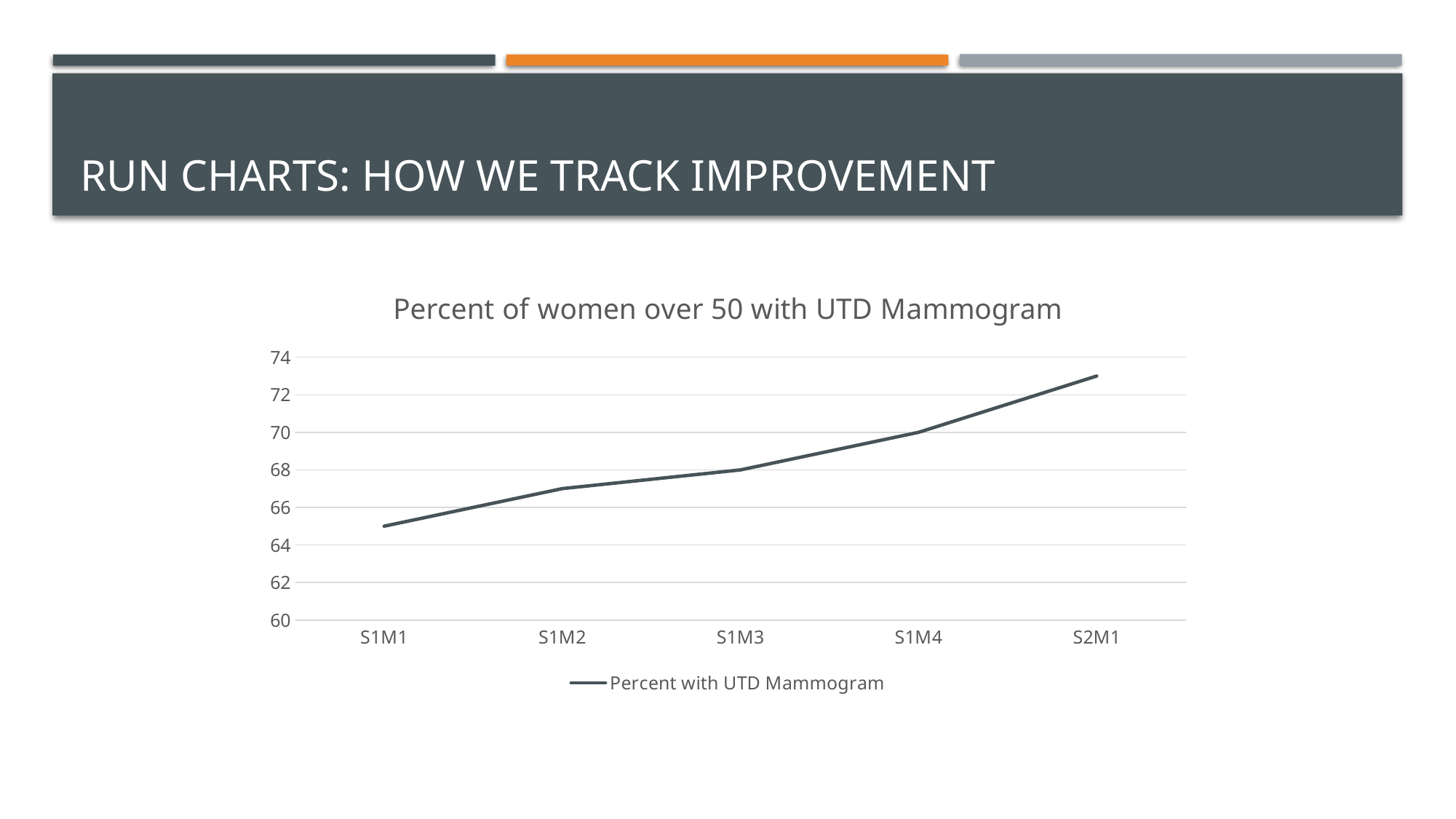
What is the value for S1M4? 70 How many points are plotted along the x axis? 5 Which point has the highest value? S2M1 Which point has the lowest value? S1M1 What kind of chart is shown on the slide? line chart What is the value for S1M3? 68 How many series does the legend list? 1 Do the values rise or fall from S1M1 to S2M1? rise Which is larger, the value for S1M2 or the value for S1M4? S1M4 Is the value for S2M1 greater or less than 72? greater What is the title of the chart? Percent of women over 50 with UTD Mammogram Is the value for S1M1 greater or less than 66? less